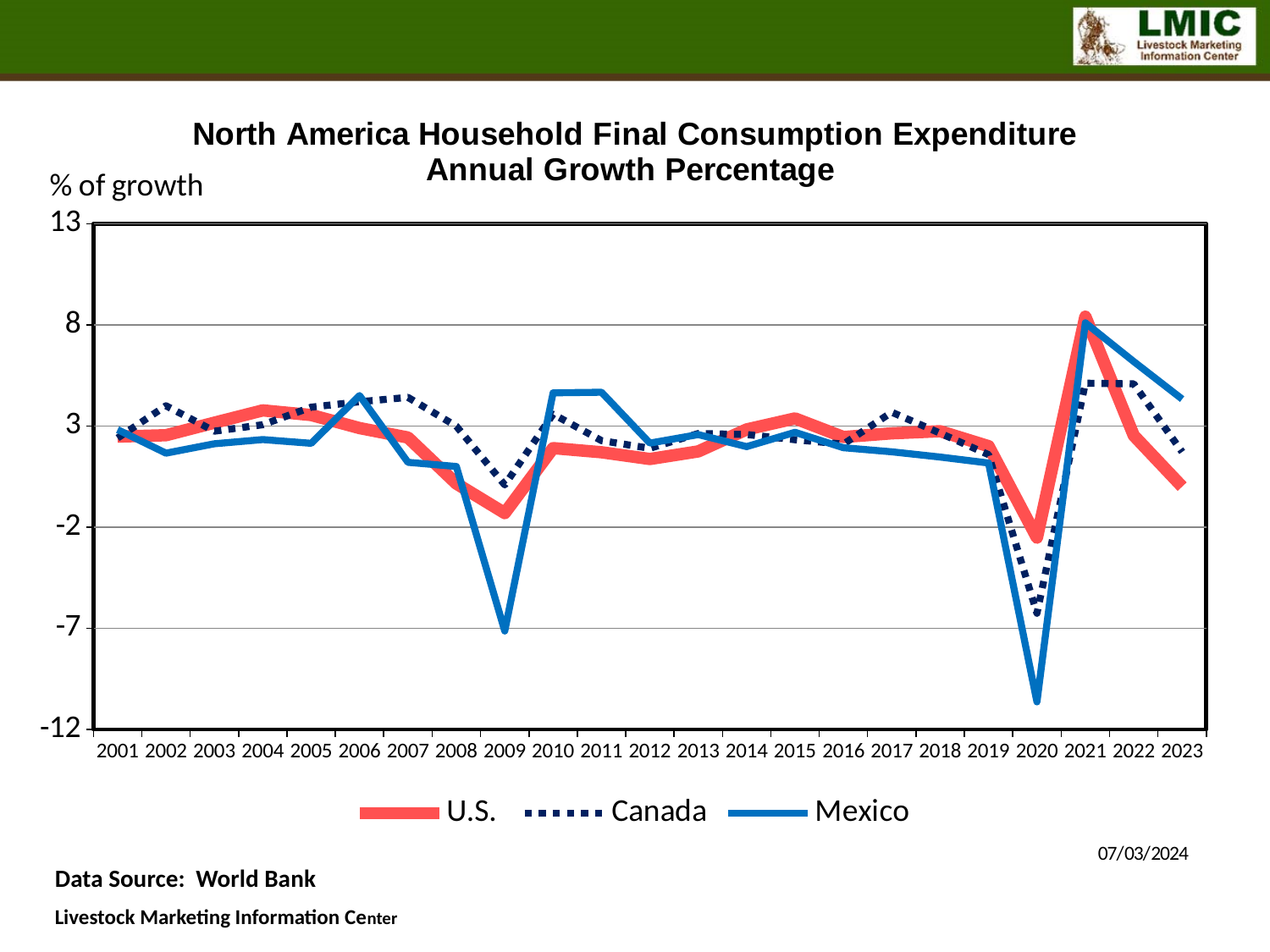
How many series does the legend list? 3 Is the value for the U.S. in 2023 greater or less than 3? less Is the value for the U.S. in 2020 greater or less than -2? less Does the U.S. line rise or fall from 2021 to 2023? fall How many years are plotted along the x axis? 23 What kind of chart is shown on the slide? line chart Which series is drawn with a dotted line? Canada Is the value for Mexico in 2023 greater or less than 3? greater In 2009, which is lower, Mexico or Canada? Mexico Which series has the lowest value in 2020? Mexico In which year does the Mexico line reach its lowest value? 2020